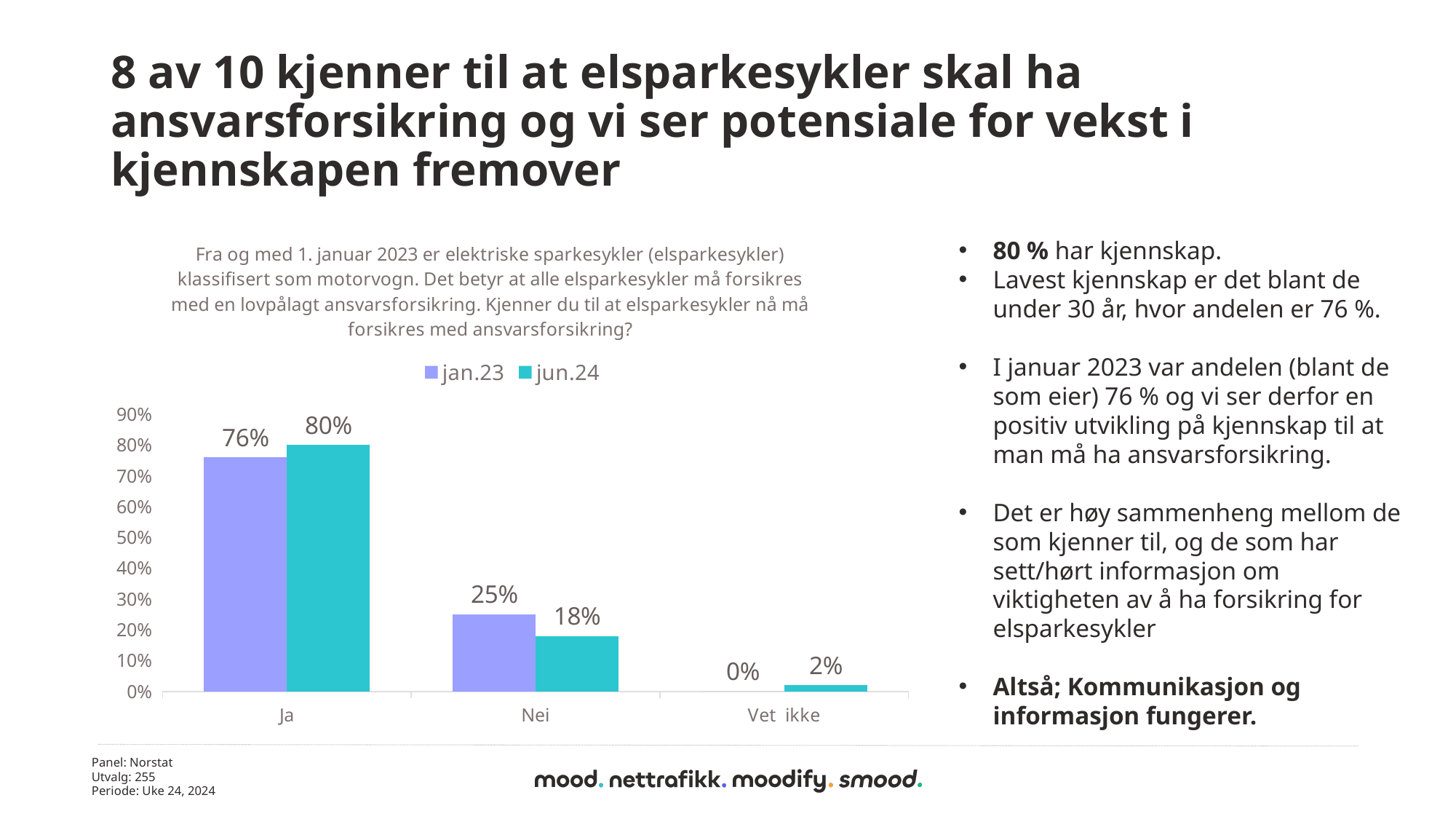
How many series does the legend list? 2 Which category has the lowest value in the jun.24 series? Vet ikke Which category has the highest value in the jan.23 series? Ja What is the value for "Ja" in the jun.24 series? 80% What is the value for "Vet ikke" in the jun.24 series? 2% How many categories are shown on the x axis? 3 What is the difference between the jan.23 and jun.24 values for "Nei"? 7% What is the difference between the jun.24 and jan.23 values for "Ja"? 4% What kind of chart is shown on the slide? Bar chart What are the two series names listed in the legend? jan.23 and jun.24 Which is larger for "Nei": the jan.23 value or the jun.24 value? jan.23 What is the value for "Nei" in the jan.23 series? 25%